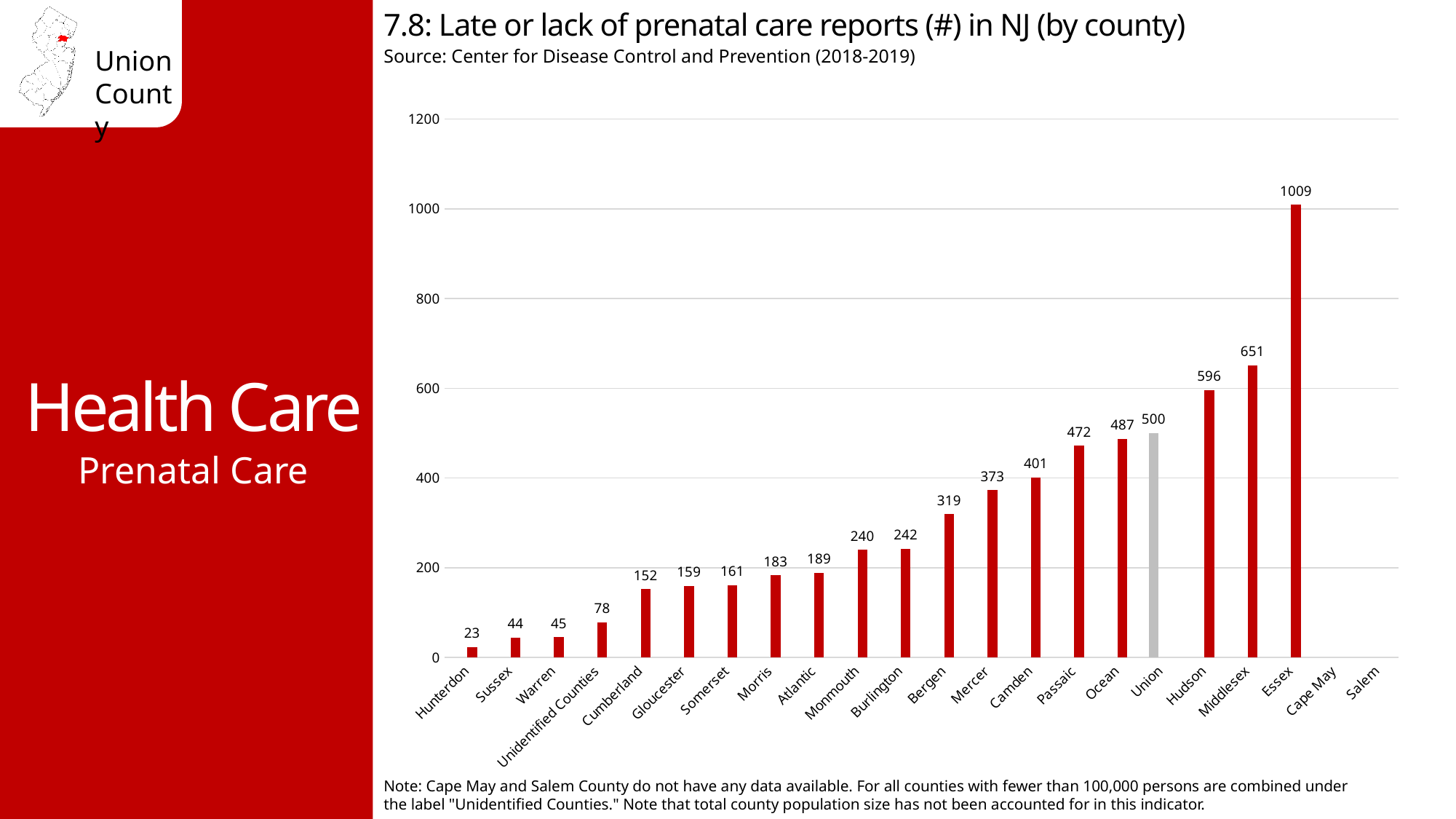
What is the value shown for Hunterdon county? 23 Which county has the highest number of late or lack of prenatal care reports? Essex What is the difference between the values for Union and Ocean? 13 What kind of chart is shown on the slide? Bar chart Which bar is coloured grey instead of red? Union Is the value for Bergen greater or less than 400? less Which county with a plotted bar has the lowest number of reports? Hunterdon What is the number of late or lack of prenatal care reports for Union county? 500 What is the value shown for Essex county? 1009 Do the values generally rise or fall moving from left to right along the x axis? Rise What is the difference between the values for Essex and Middlesex? 358 Which has a larger value, Hudson or Passaic? Hudson